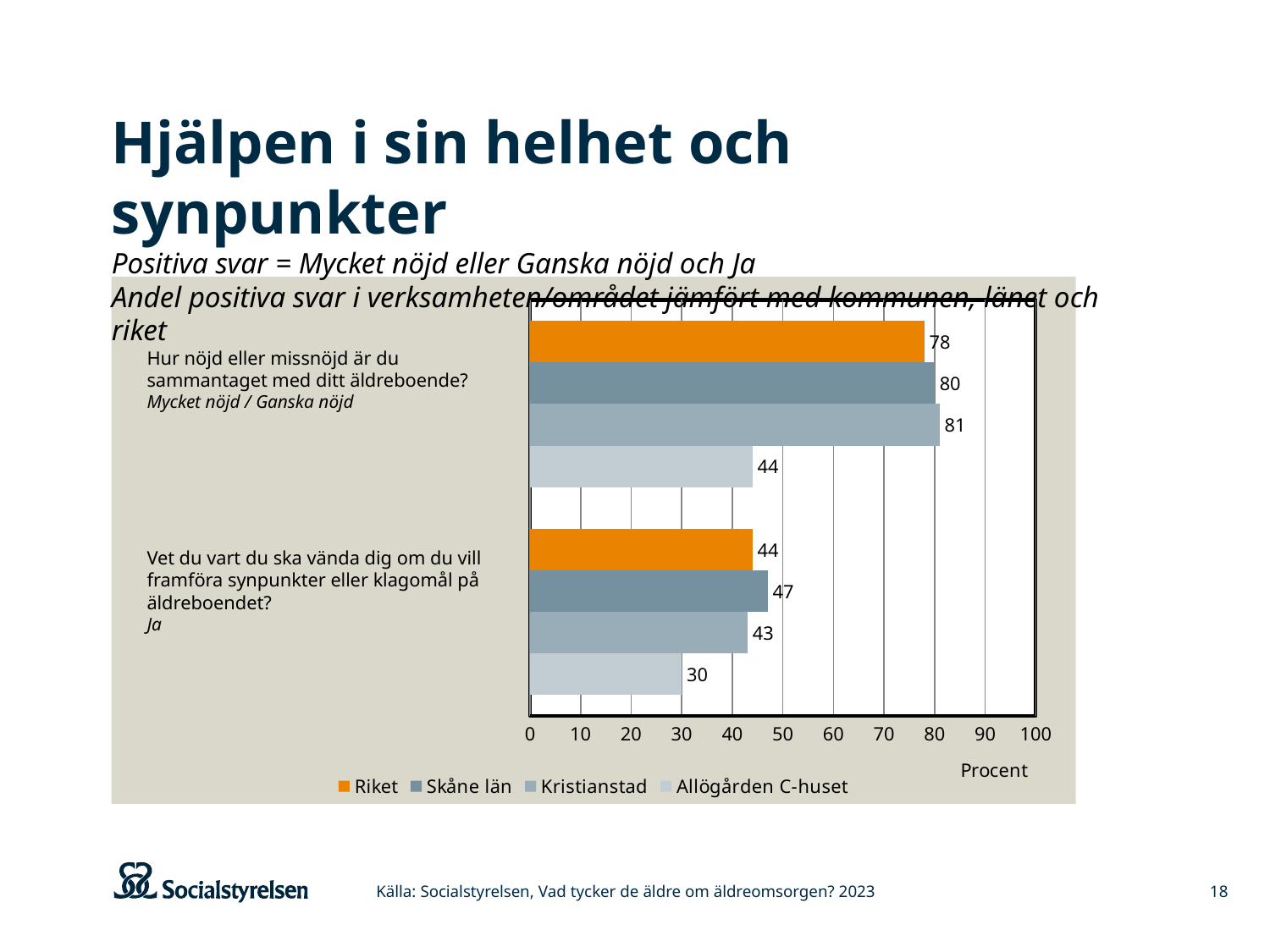
How many series does the legend list? 4 What is the value for Skåne län on the question about knowing where to turn with complaints (Vet du vart du ska vända dig...)? 47 Which series has the highest value on the question about overall satisfaction with the elderly home? Kristianstad What is the value for Allögården C-huset on the question about overall satisfaction with the elderly home? 44 What kind of chart is shown on the slide? bar chart What is the value for Riket on the question about overall satisfaction with the elderly home (Hur nöjd eller missnöjd är du sammantaget med ditt äldreboende?)? 78 Which series has the lowest value on the question about knowing where to turn with complaints? Allögården C-huset What label is shown on the x axis of the chart? Procent What is the value for Allögården C-huset on the question about knowing where to turn with complaints? 30 What is the difference between Skåne län and Kristianstad on the question about knowing where to turn with complaints? 4 What is the difference between Kristianstad and Allögården C-huset on the question about overall satisfaction with the elderly home? 37 Which is larger on the question about knowing where to turn with complaints: Riket or Allögården C-huset? Riket